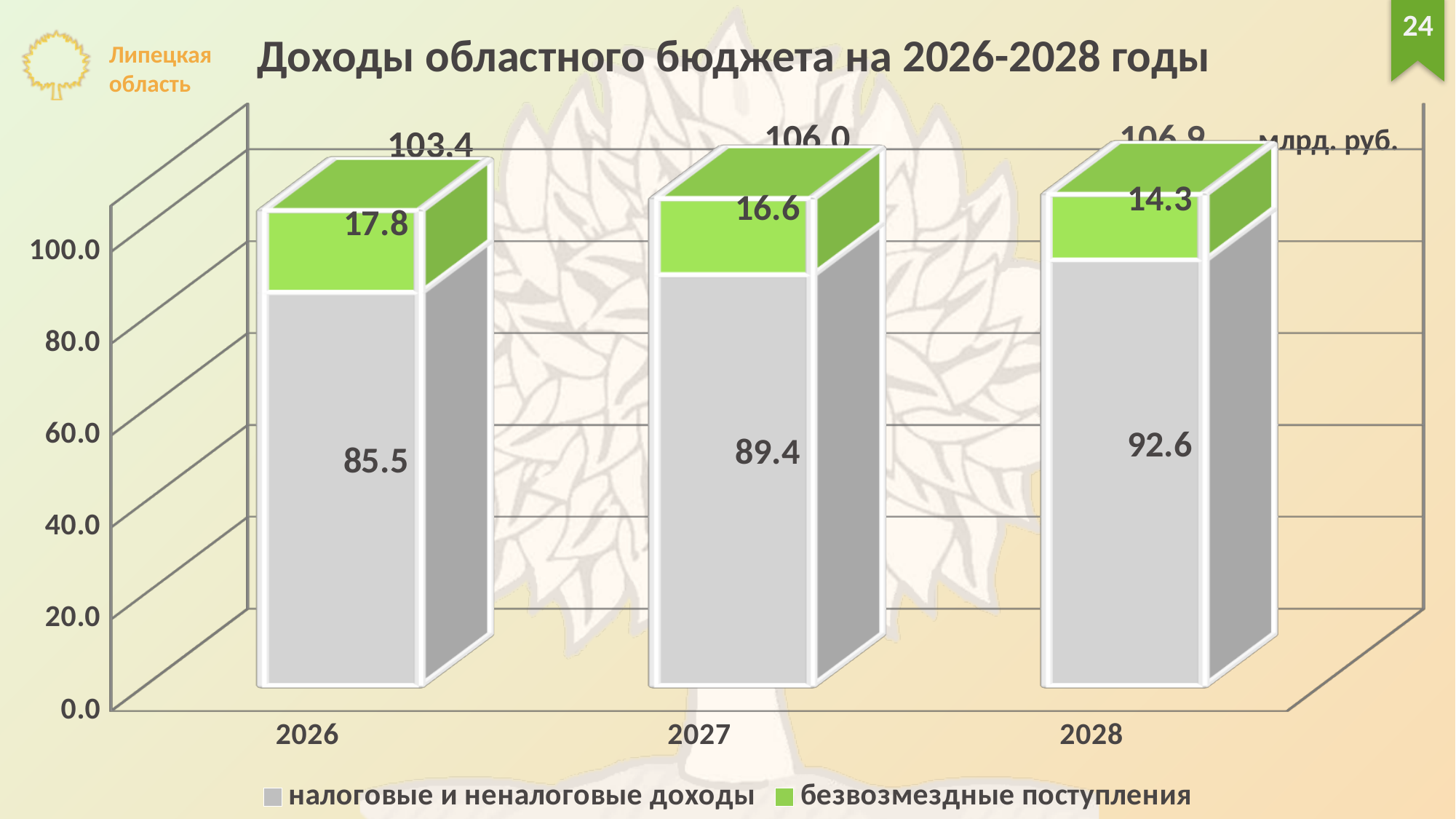
What unit is indicated for the values on the chart? млрд. руб. Do the values for налоговые и неналоговые доходы rise or fall from 2026 to 2028? Rise Which year has the highest value for налоговые и неналоговые доходы? 2028 Which year has the lowest value for безвозмездные поступления? 2028 What is the difference between налоговые и неналоговые доходы in 2028 and in 2026? 7.1 What is the total shown above the bar for 2028? 106.9 How many series does the legend list? 2 What kind of chart is shown on the slide? Stacked bar chart Which is larger: безвозмездные поступления in 2026 or in 2028? 2026 What is the value of налоговые и неналоговые доходы for 2026? 85.5 What is the value of безвозмездные поступления for 2027? 16.6 How many years are shown on the x axis? 3